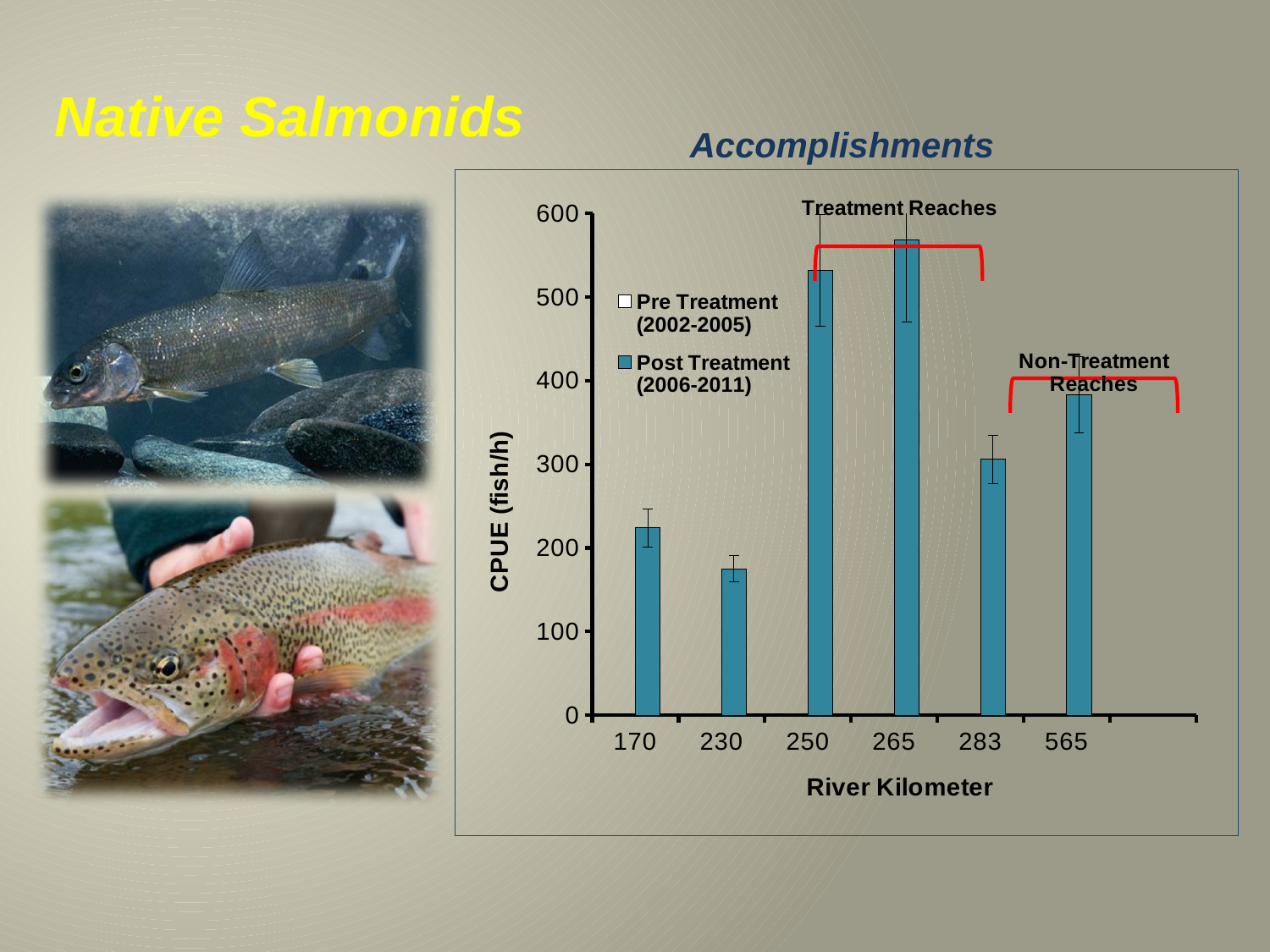
Is the CPUE value for river kilometer 230 greater or less than 200? less How many river kilometer categories are shown on the x axis of the chart? 6 What kind of chart is shown on the slide? bar chart Is the CPUE value for river kilometer 283 greater or less than 400? less Is the CPUE value for river kilometer 170 greater or less than 200? greater What is the title of the chart's y axis? CPUE (fish/h) Which has the larger CPUE bar, river kilometer 250 or river kilometer 283? 250 Which river kilometer has the highest CPUE bar? 265 Which river kilometer has the lowest CPUE bar? 230 How many series does the chart's legend list? 2 Which has the larger CPUE bar, river kilometer 170 or river kilometer 230? 170